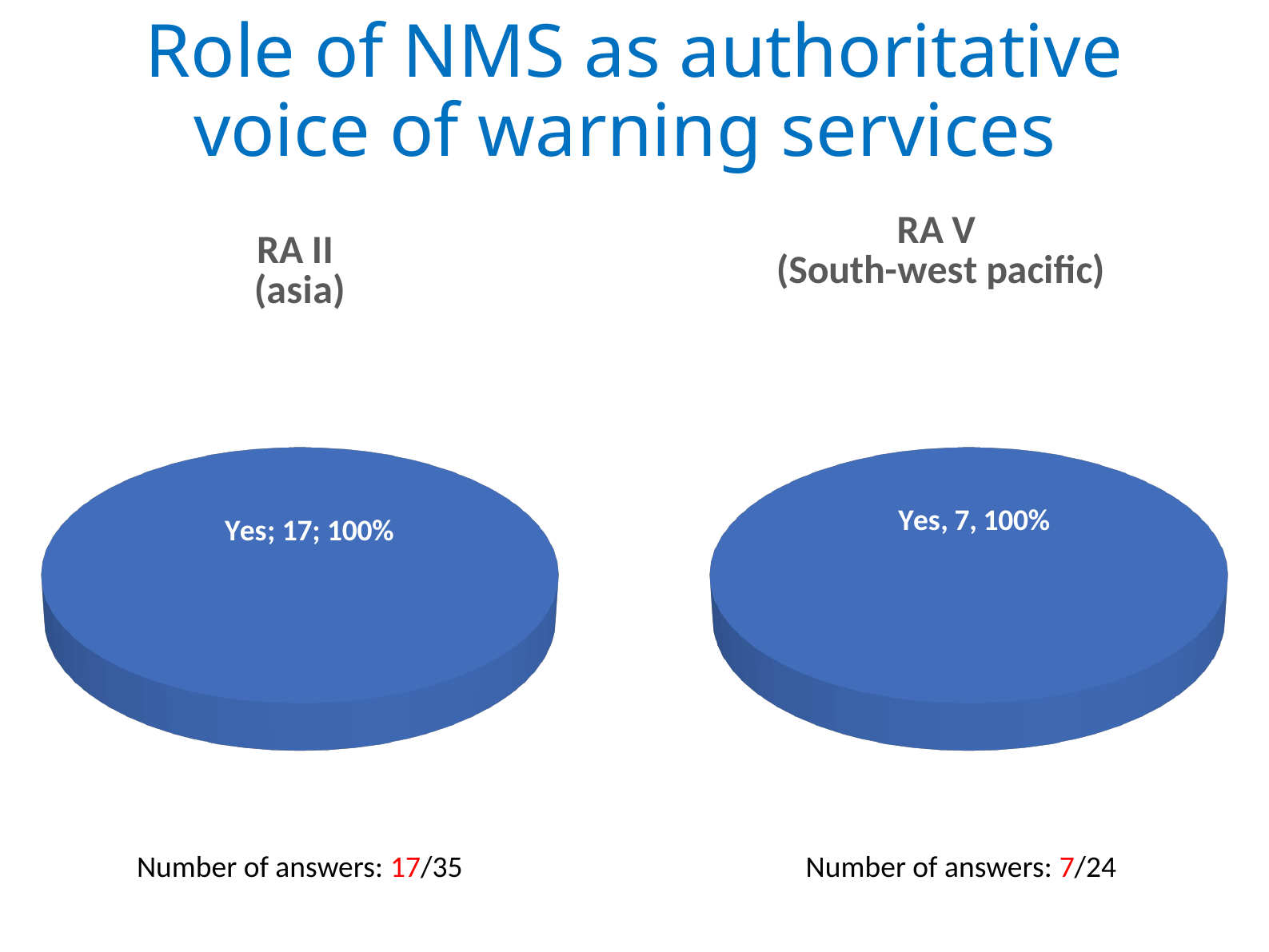
In the RA V (South-west pacific) chart, what value is shown for the Yes slice? 7 In the RA II (asia) chart, what value is shown for the Yes slice? 17 What is the title of the chart on the right of the slide? RA V (South-west pacific) How many slices does the RA V (South-west pacific) pie chart have? 1 What kind of chart is the RA II (asia) chart? Pie chart In the RA II (asia) chart, what share of the pie does the Yes slice represent? 100% What is the title of the chart on the left of the slide? RA II (asia) In the RA V (South-west pacific) chart, what share of the pie does the Yes slice represent? 100% How many slices does the RA II (asia) pie chart have? 1 Which chart has the larger Yes count, RA II (asia) or RA V (South-west pacific)? RA II (asia) What kind of chart is the RA V (South-west pacific) chart? Pie chart What is the difference between the Yes count in the RA II (asia) chart and the Yes count in the RA V (South-west pacific) chart? 10